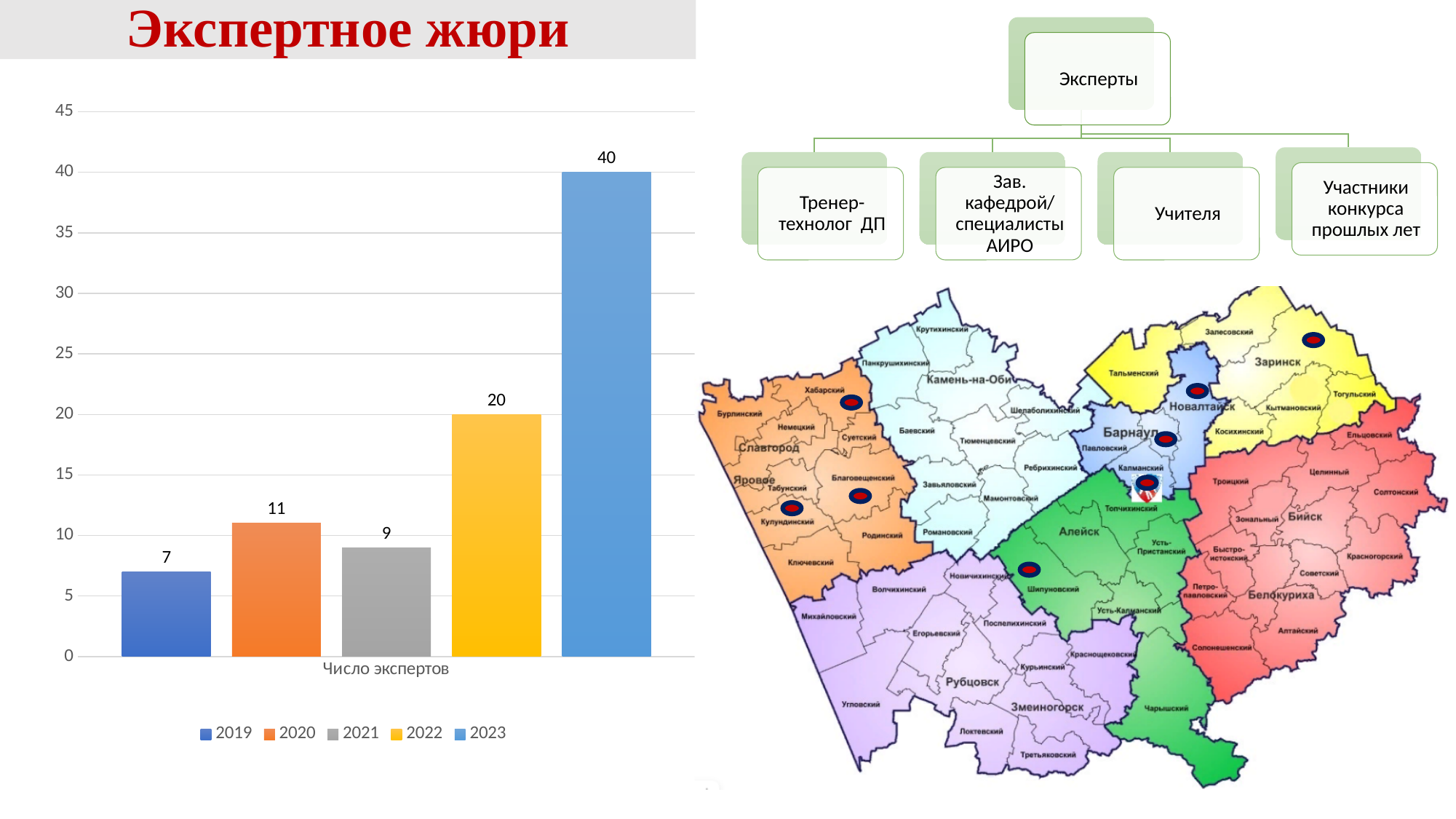
What is the number of experts for 2019? 7 What is the difference between the number of experts in 2020 and 2021? 2 Which year has more experts, 2020 or 2021? 2020 How many series does the legend list? 5 What kind of chart is shown on the slide? bar chart What is the number of experts for 2023? 40 What is the label shown on the horizontal axis of the chart? Число экспертов Is the value for 2022 greater or less than 15? greater Which year has the highest number of experts? 2023 Which year has the lowest number of experts? 2019 What is the difference between the number of experts in 2023 and 2022? 20 What is the number of experts for 2021? 9